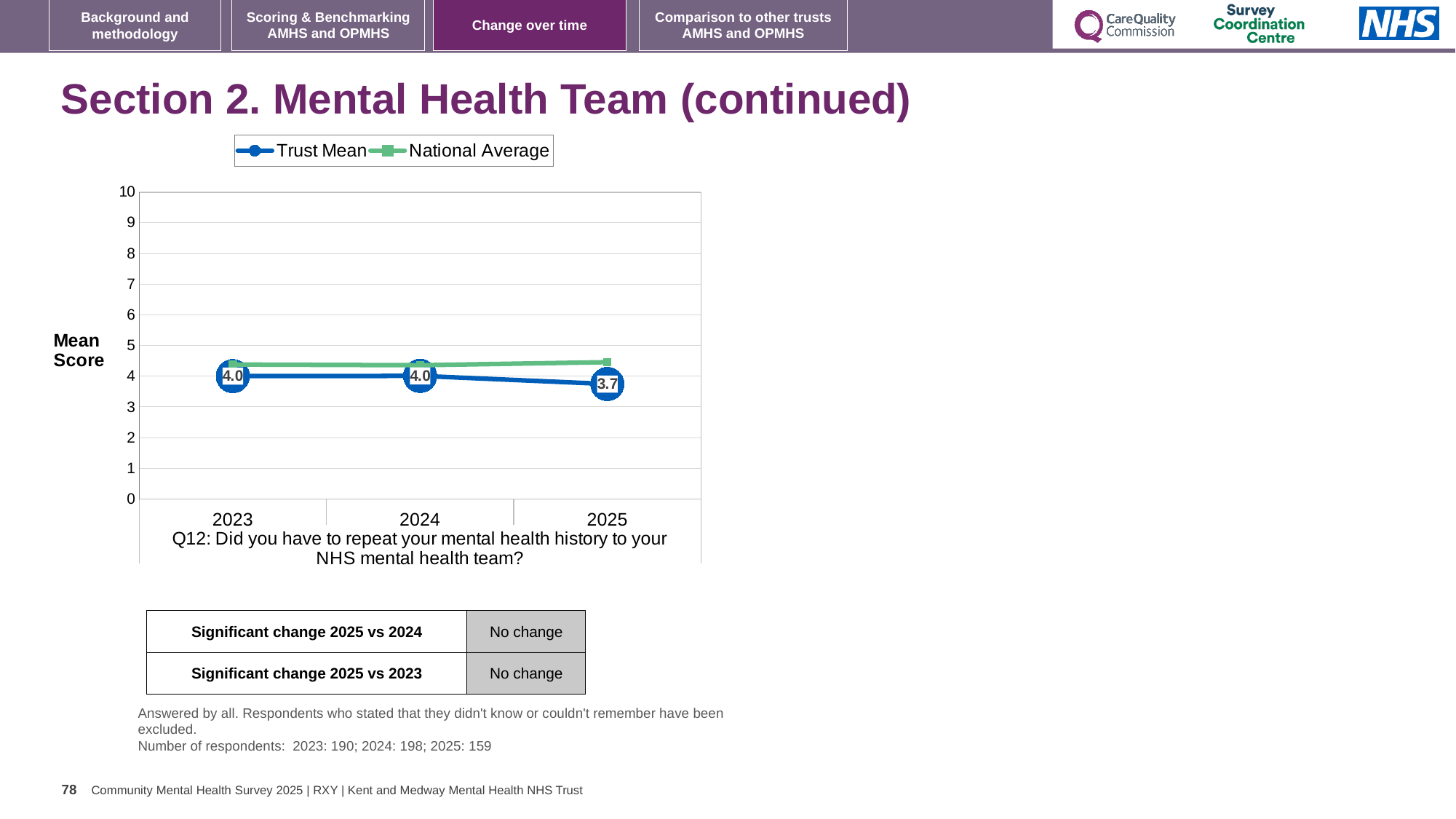
What is the Trust Mean score for 2024? 4.0 How many series does the legend list? 2 Is the National Average value for 2023 greater or less than 4? greater Does the Trust Mean rise or fall from 2024 to 2025? fall How many years are shown on the x axis of the chart? 3 What kind of chart is shown on the slide? line chart Which is larger, the Trust Mean score for 2024 or for 2025? 2024 What is the difference between the Trust Mean score in 2023 and in 2025? 0.3 Is the National Average value for 2025 greater or less than 5? less In which year is the Trust Mean score lowest? 2025 What is the Trust Mean score for 2023? 4.0 What is the Trust Mean score for 2025? 3.7